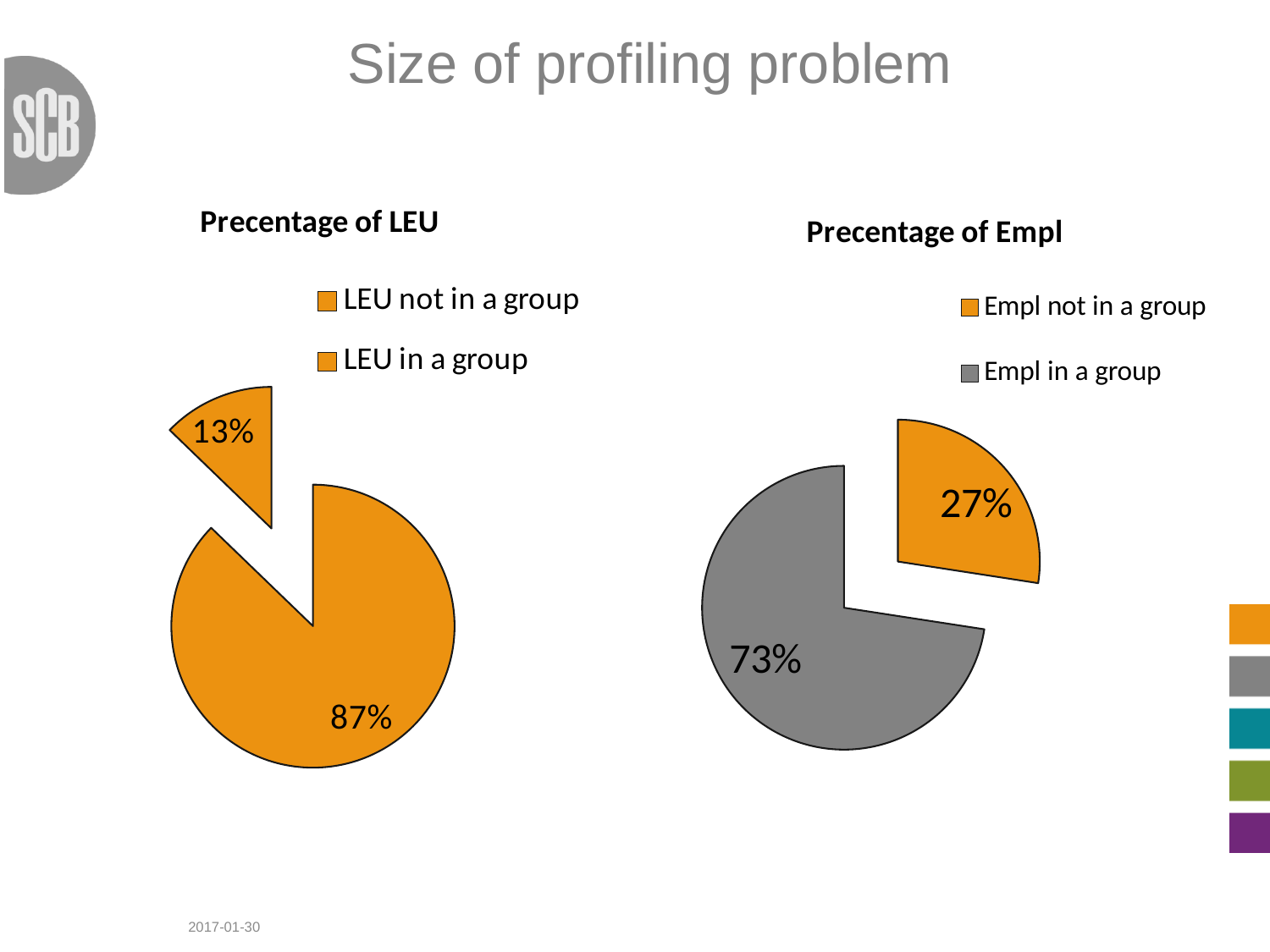
In the 'Precentage of Empl' chart, which category has the larger slice? Empl in a group What kind of chart is the 'Precentage of LEU' chart? pie chart In the 'Precentage of Empl' chart, what is the difference in percentage points between Empl in a group and Empl not in a group? 46 In the 'Precentage of Empl' chart, which category has the smaller slice? Empl not in a group In the 'Precentage of LEU' chart, what is the value of the largest slice? 87% In the 'Precentage of LEU' chart, what is the value of the smallest slice? 13% How many entries does the legend of the 'Precentage of LEU' chart list? 2 In the 'Precentage of Empl' chart, what share is labelled for Empl not in a group? 27% In the 'Precentage of Empl' chart, what share is labelled for Empl in a group? 73% In the 'Precentage of Empl' chart, what colour is the slice for Empl in a group? grey In the 'Precentage of LEU' chart, what is the difference in percentage points between the two slices? 74 How many slices does the 'Precentage of Empl' pie chart have? 2